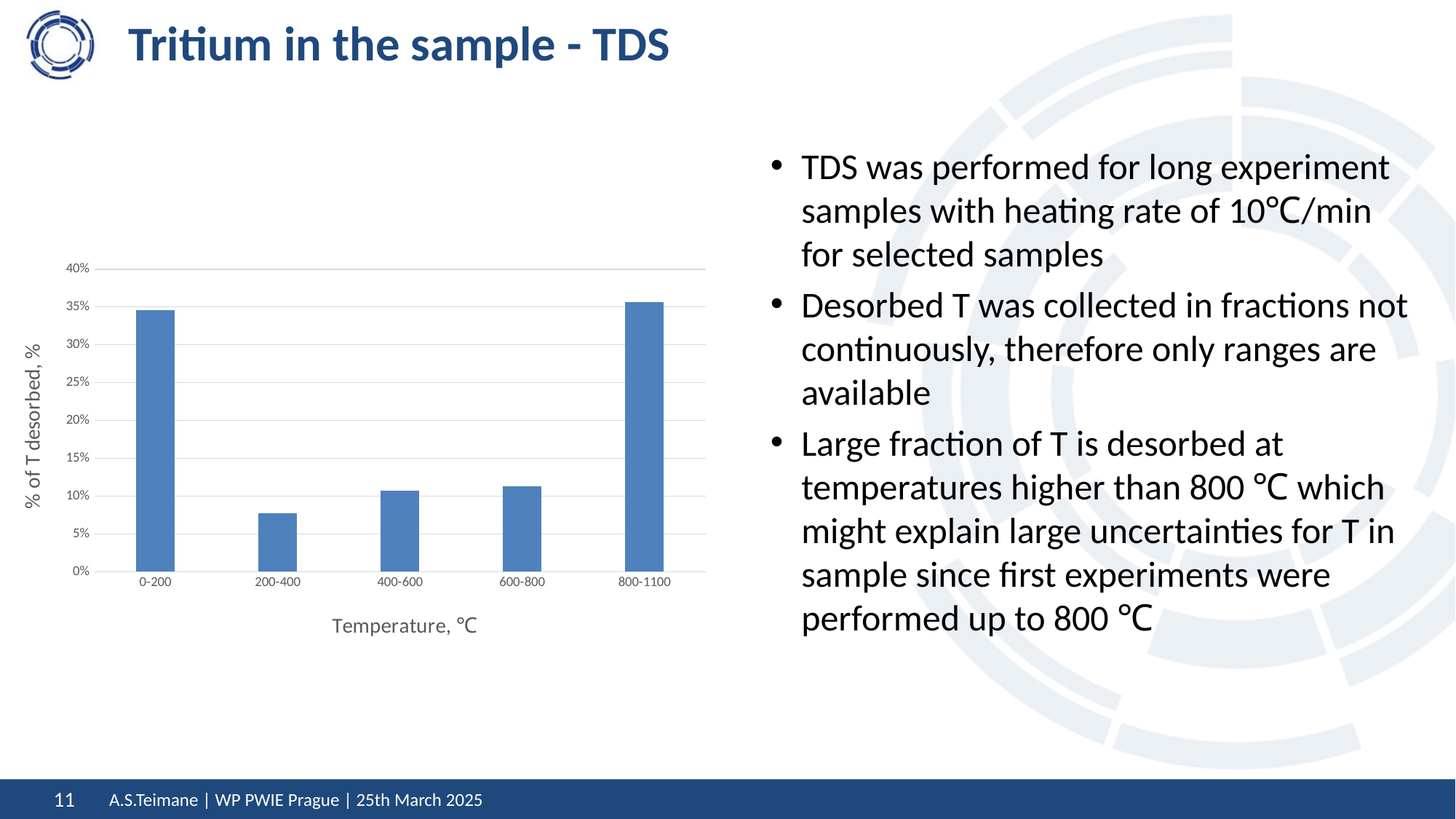
Is the value for the 800-1100 temperature range greater or less than 30%? greater Is the value for the 200-400 temperature range greater or less than 10%? less Is the value for the 0-200 temperature range greater or less than 30%? greater What is the label of the x axis of the chart? Temperature, °C Which has a higher % of T desorbed, the 600-800 range or the 800-1100 range? 800-1100 Which temperature range has the lowest % of T desorbed? 200-400 How many temperature ranges are shown on the x axis of the chart? 5 Which has a higher % of T desorbed, the 0-200 range or the 200-400 range? 0-200 What is the label of the y axis of the chart? % of T desorbed, % What kind of chart is shown on the slide? bar chart